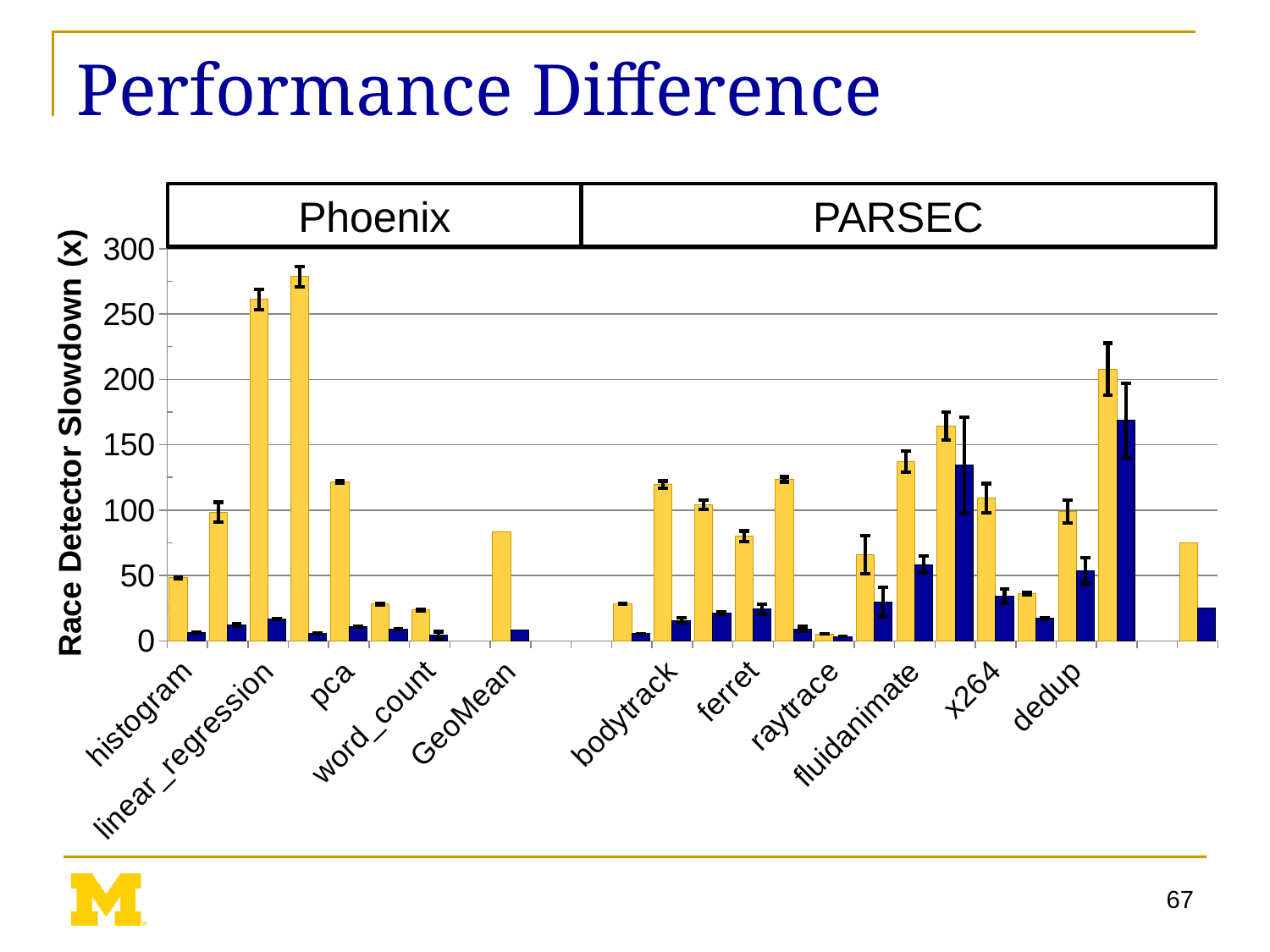
What kind of chart is shown on the slide? bar chart Which colour of bars is generally taller across the chart, yellow or blue? yellow Which section of the chart contains the tallest blue bar, Phoenix or PARSEC? PARSEC Is the tallest blue bar in the chart greater or less than 150? greater What are the two benchmark suite headers shown above the chart? Phoenix and PARSEC Is the tallest yellow bar in the chart greater or less than 250? greater Is the tallest blue bar in the Phoenix section greater or less than 50? less What is the label of the vertical axis? Race Detector Slowdown (x) How many distinct bar colours are plotted in the chart? 2 What is the highest tick value shown on the vertical axis? 300 Which section of the chart contains the tallest bar overall, Phoenix or PARSEC? Phoenix